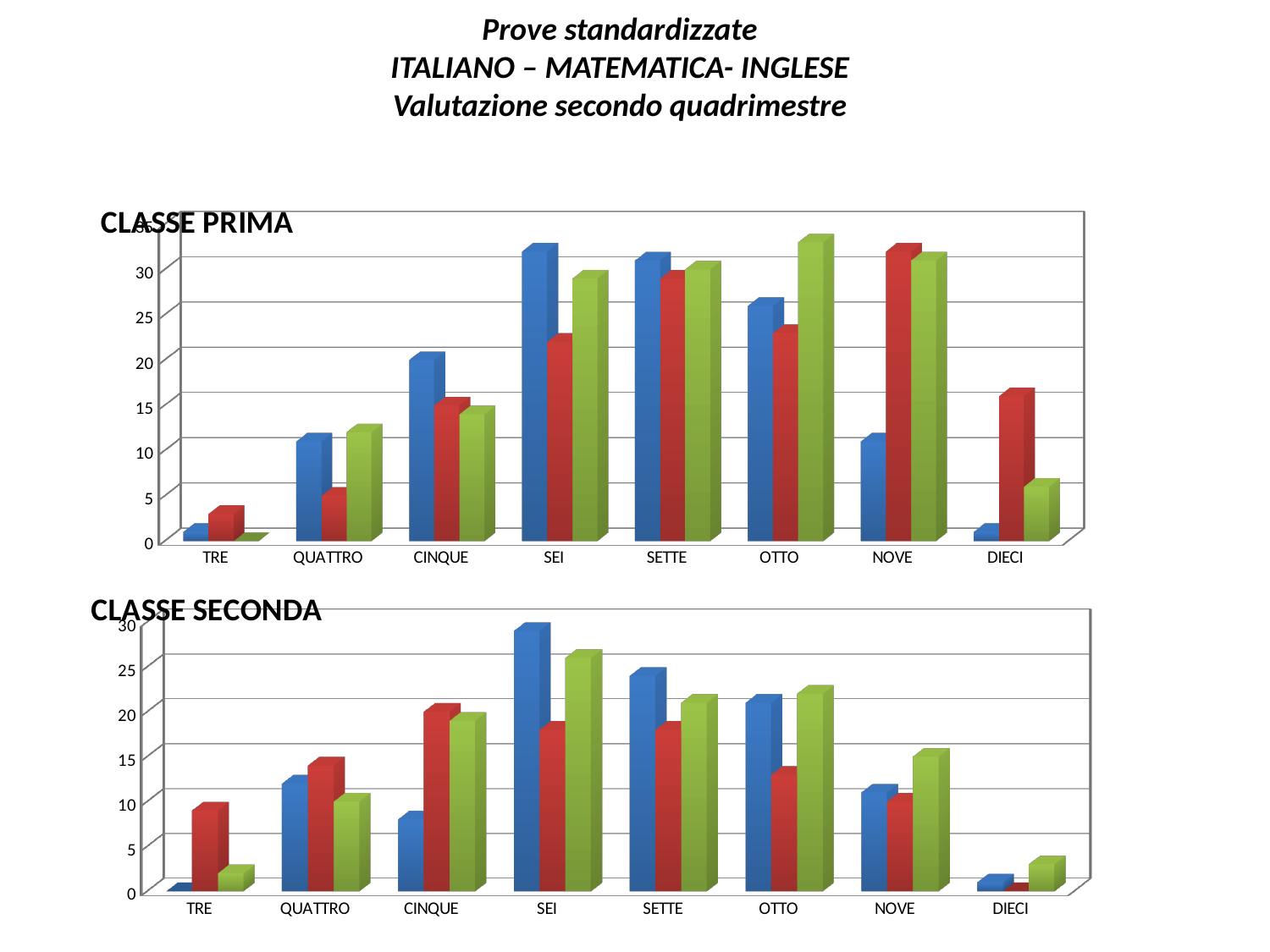
What kind of chart is the CLASSE PRIMA chart? bar chart In the CLASSE PRIMA chart, at DIECI, which is larger: the red bar or the green bar? the red bar In the CLASSE PRIMA chart, is the red bar for DIECI greater or less than 10? greater In the CLASSE SECONDA chart, which category has the tallest green bar? SEI In the CLASSE SECONDA chart, which category has the tallest blue bar? SEI In the CLASSE PRIMA chart, is the green bar for OTTO greater or less than 30? greater In the CLASSE PRIMA chart, which category has the lowest green bar? TRE In the CLASSE SECONDA chart, is the blue bar for CINQUE greater or less than 10? less What are the titles of the two charts on the slide? CLASSE PRIMA and CLASSE SECONDA In the CLASSE SECONDA chart, which category has the lowest red bar? DIECI How many categories are shown on the x axis of the CLASSE SECONDA chart? 8